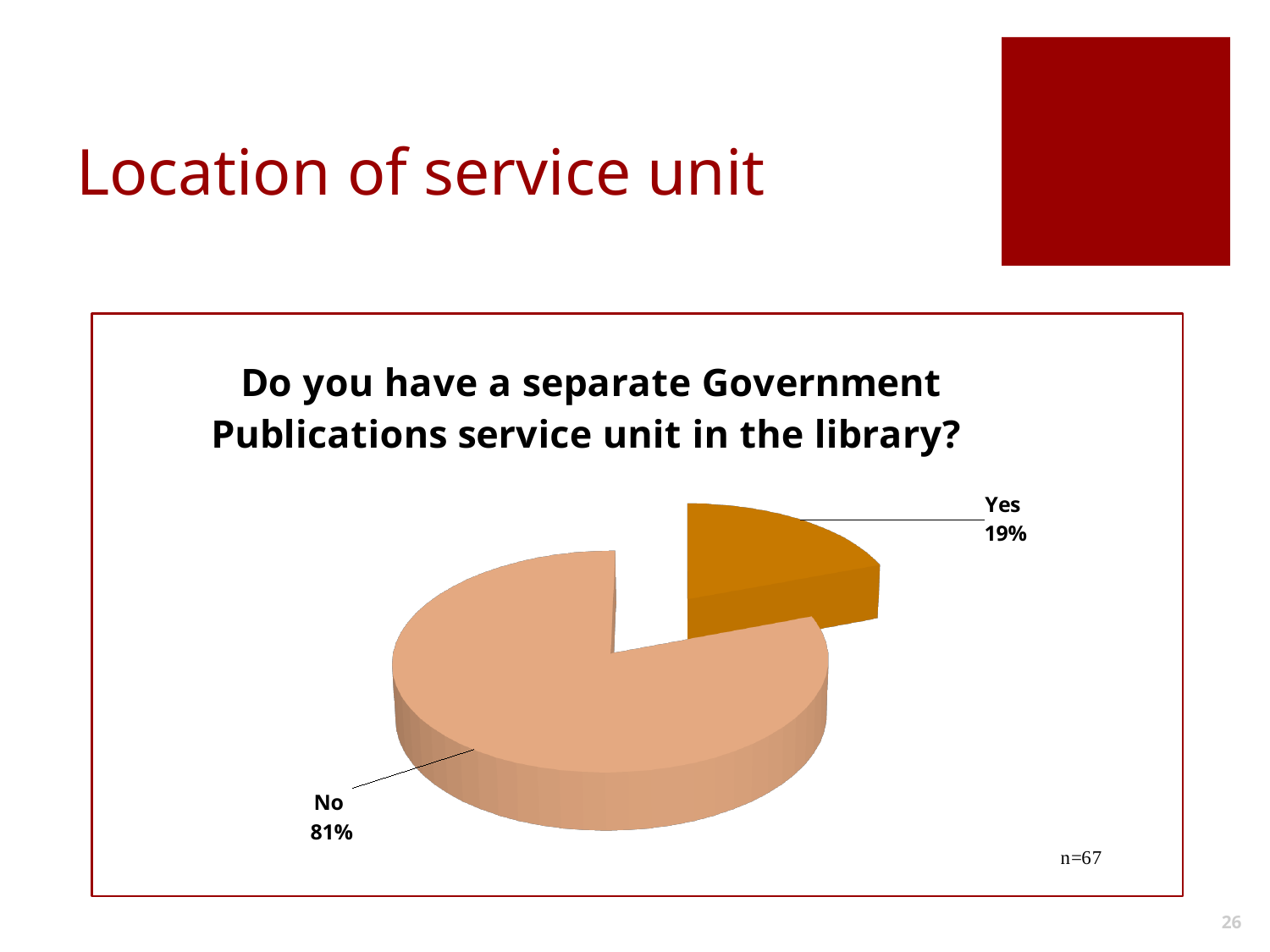
What percentage of respondents answered "Yes" to having a separate Government Publications service unit? 19% Which is larger, the "Yes" share or the "No" share? No What is the difference in percentage points between the "No" and "Yes" shares? 62 What is the title of the chart? Do you have a separate Government Publications service unit in the library? Which response has the smallest share of the pie? Yes How many slices does the pie chart have? 2 Which response has the largest share of the pie? No What share of the pie does the "Yes" slice represent? 19% What kind of chart is shown on the slide? Pie chart What is the sample size (n) noted on the chart? 67 What percentage of respondents answered "No"? 81%